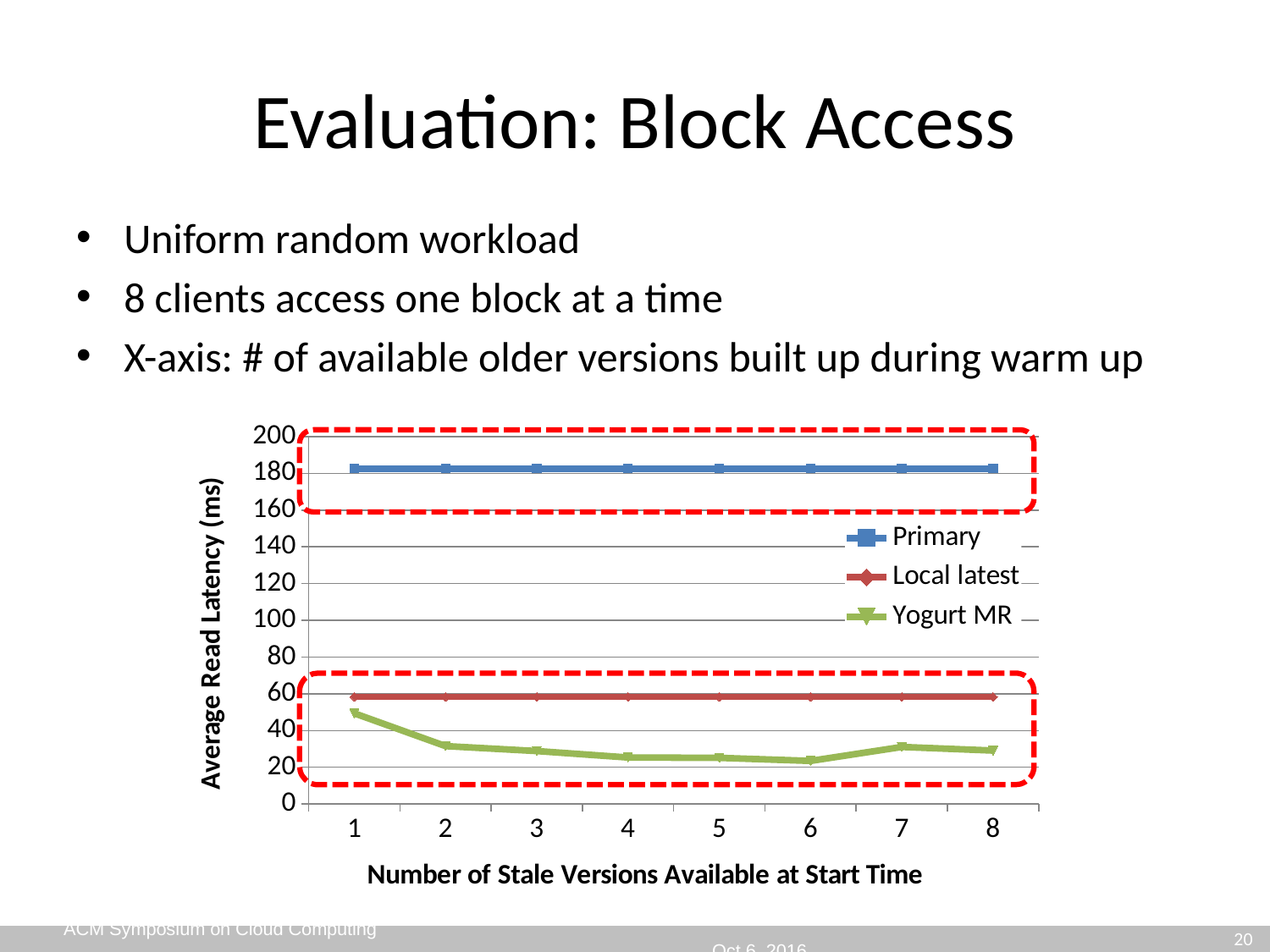
Is the value for Yogurt MR at 6 stale versions greater or less than 40? less Is the value for Yogurt MR at 1 stale version greater or less than 60? less Does the Yogurt MR series rise or fall from 1 to 6 stale versions? fall What is the title of the y axis? Average Read Latency (ms) How many series does the legend list? 3 Is the value for Primary at 1 stale version greater or less than 160? greater Which series has the highest average read latency? Primary Which series has the lowest average read latency at 6 stale versions? Yogurt MR How many points along the x axis does each series have? 8 What kind of chart is shown on the slide? line chart Which is larger, the value for Local latest or the value for Yogurt MR at 2 stale versions? Local latest